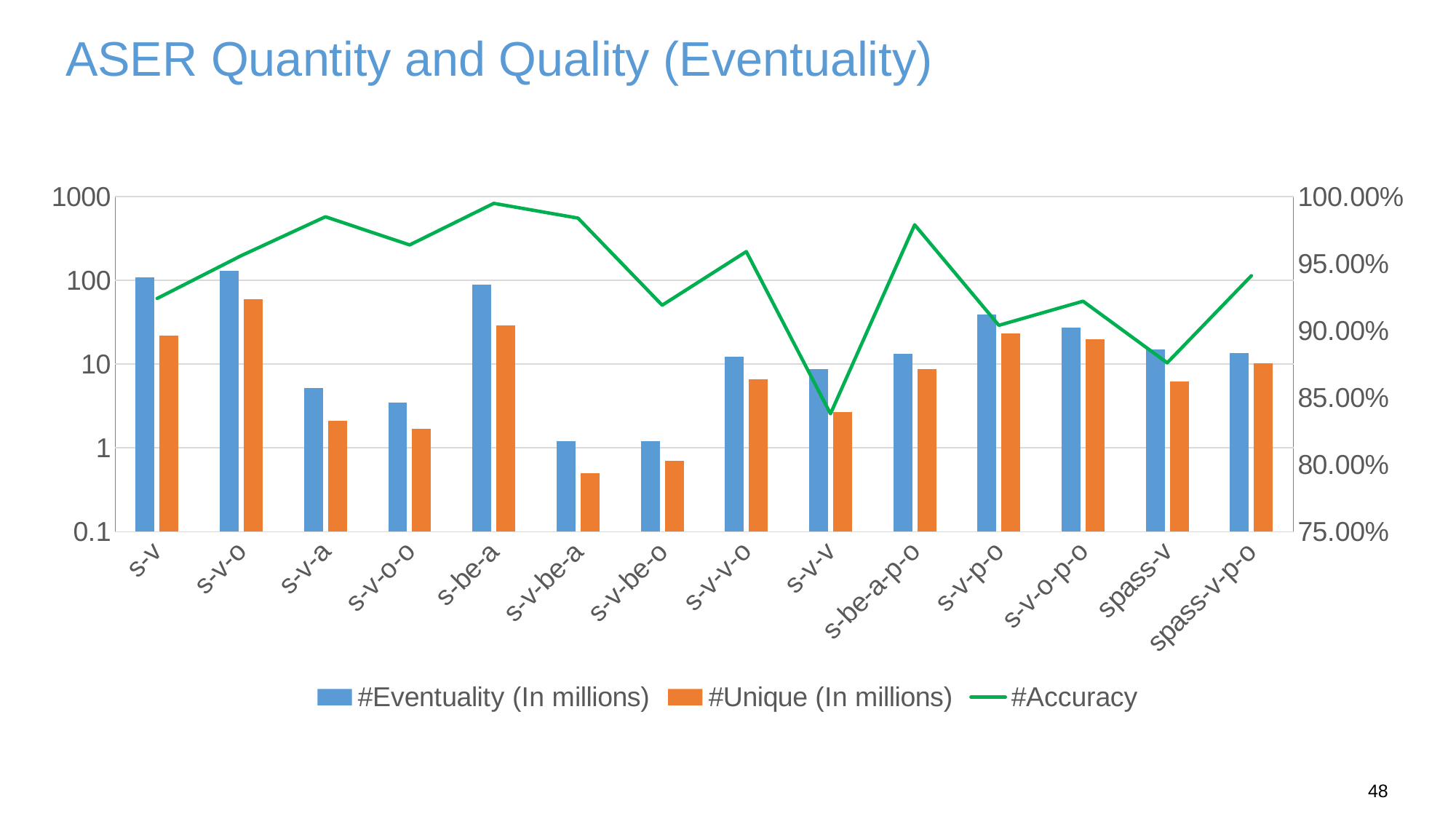
Is the #Eventuality (In millions) value for s-v-a greater or less than 10? less What kind of chart is shown on the slide? A combined bar and line chart Which category has the lowest #Accuracy? s-v-v Is the #Eventuality (In millions) value for s-v-o greater or less than 100? greater How many categories are shown on the x axis? 14 Which category has the highest #Accuracy? s-be-a How many series does the legend list? 3 Which has the higher #Accuracy, s-v-o or s-v-v? s-v-o Which has the larger #Eventuality (In millions) value, s-v-o or s-v-a? s-v-o Is the #Unique (In millions) value for s-be-a greater or less than 10? greater What is the title of the slide? ASER Quantity and Quality (Eventuality)